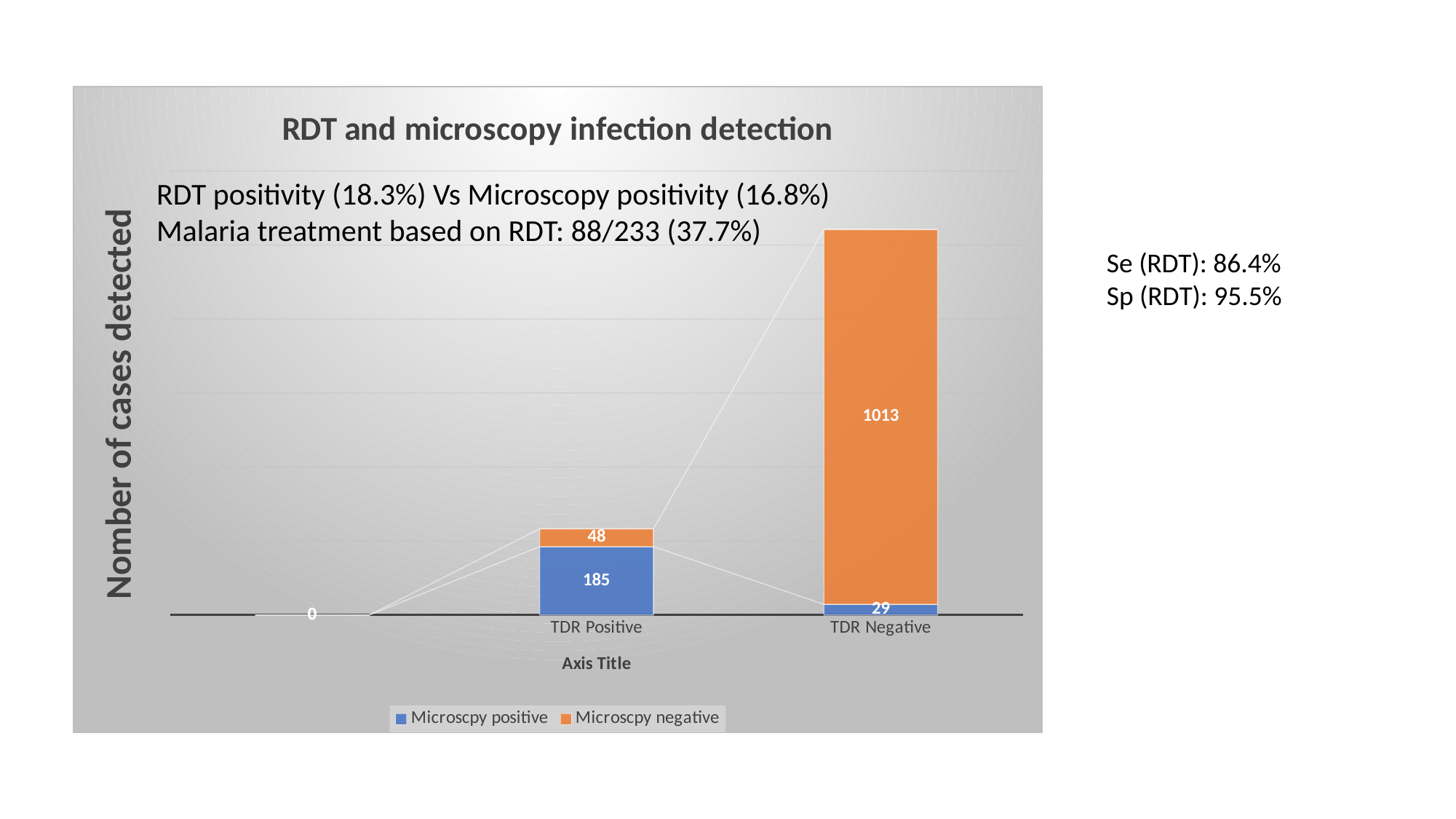
What kind of chart is shown on the slide? Stacked bar chart What is the difference between the Microscpy negative and Microscpy positive values for TDR Negative? 984 What is the value of the Microscpy negative series for TDR Positive? 48 Which has the larger Microscpy positive value, TDR Positive or TDR Negative? TDR Positive Which category has the highest Microscpy negative value? TDR Negative What is the total of the stacked bar for TDR Negative? 1042 What is the value of the Microscpy positive series for TDR Positive? 185 How many series does the legend list? 2 What is the total of the stacked bar for TDR Positive? 233 What is the value of the Microscpy negative series for TDR Negative? 1013 What is the value of the Microscpy positive series for TDR Negative? 29 What is the difference between the Microscpy positive and Microscpy negative values for TDR Positive? 137